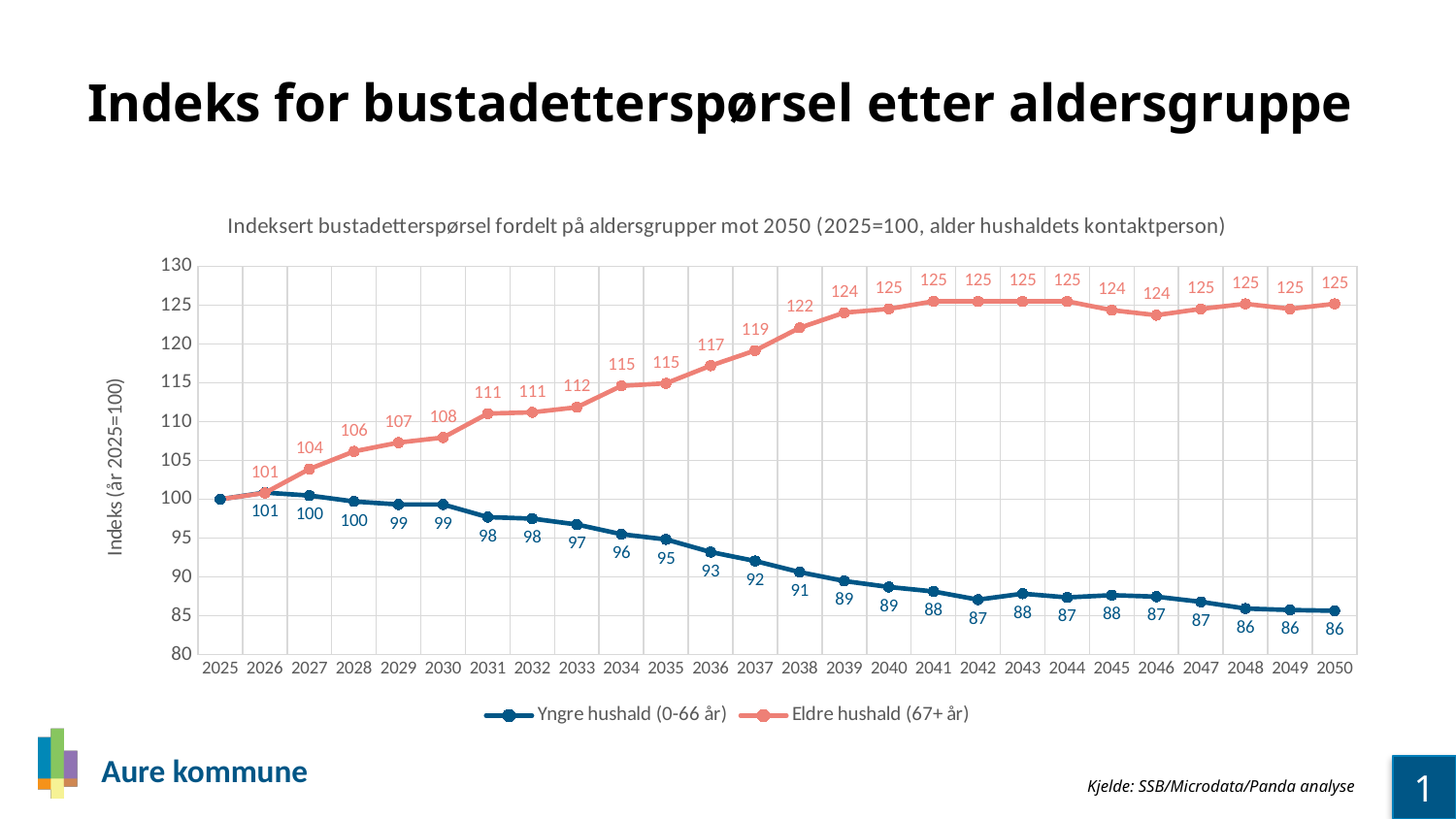
What is the value for Yngre hushald (0-66 år) in 2036? 93 Does the Eldre hushald (67+ år) series rise or fall from 2025 to 2040? rise What is the value for Yngre hushald (0-66 år) in 2050? 86 What is the value for Eldre hushald (67+ år) in 2038? 122 What is the value for Eldre hushald (67+ år) in 2050? 125 Which series has the higher value in 2040, Yngre hushald (0-66 år) or Eldre hushald (67+ år)? Eldre hushald (67+ år) Does the Yngre hushald (0-66 år) series rise or fall from 2025 to 2050? fall What is the label of the y axis? Indeks (år 2025=100) How many series does the legend list? 2 What is the difference between Eldre hushald (67+ år) and Yngre hushald (0-66 år) in 2050? 39 How many years are plotted on the x axis? 26 What type of chart is shown on the slide? line chart